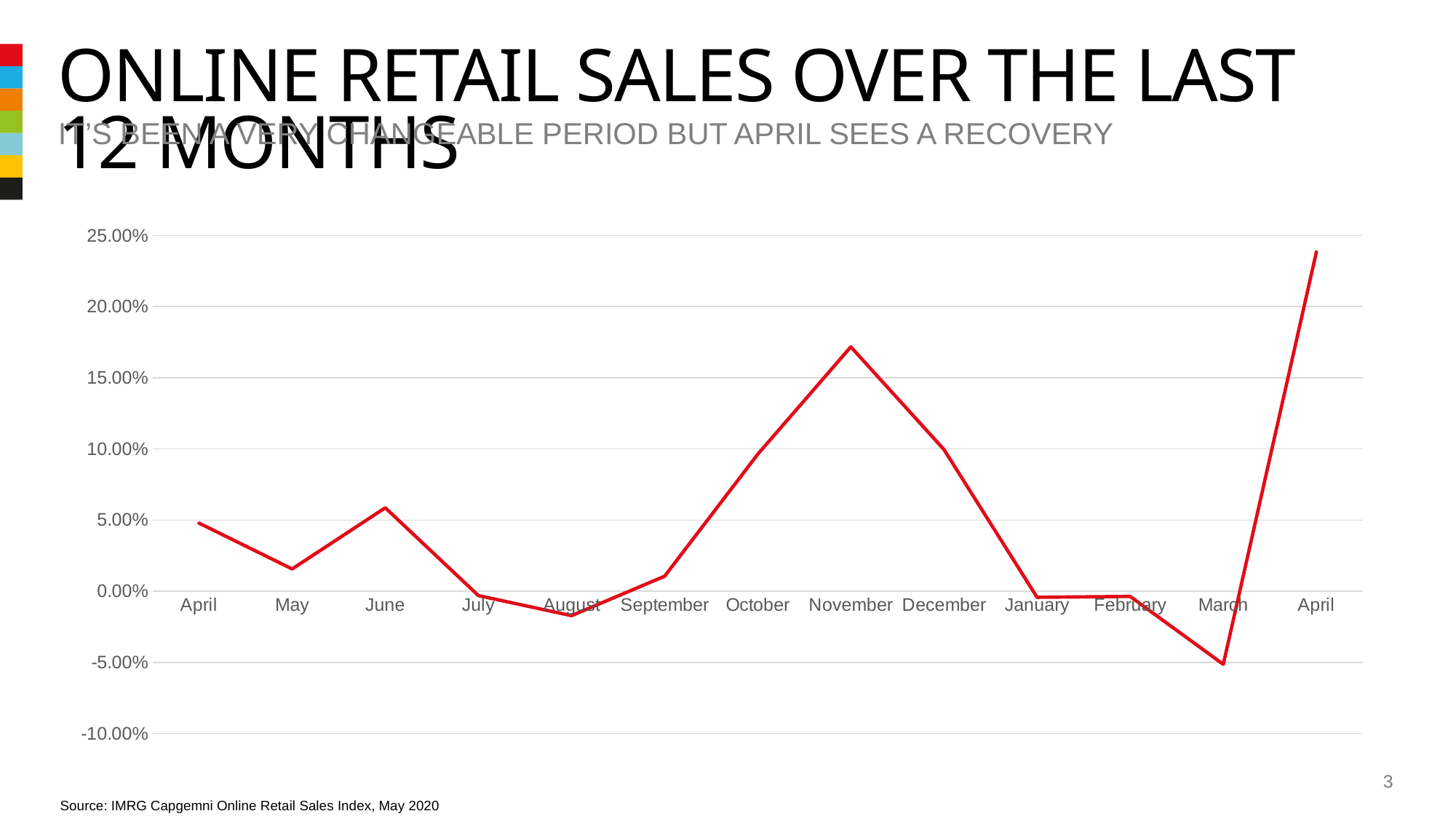
Is the value for November greater or less than 15.00%? greater Is the value for the rightmost April greater or less than 20.00%? greater Which month has the highest value on the chart? April (the rightmost point) How many months (data points) are plotted on the chart? 13 Which month has the lowest value on the chart? March Is the value for March greater or less than 0.00%? less What kind of chart is shown on the slide? line chart Which is larger, the value for June or the value for May? June Do the values rise or fall from November to March? fall Which is larger, the value for November or the value for December? November What is the source cited for the chart data? IMRG Capgemni Online Retail Sales Index, May 2020